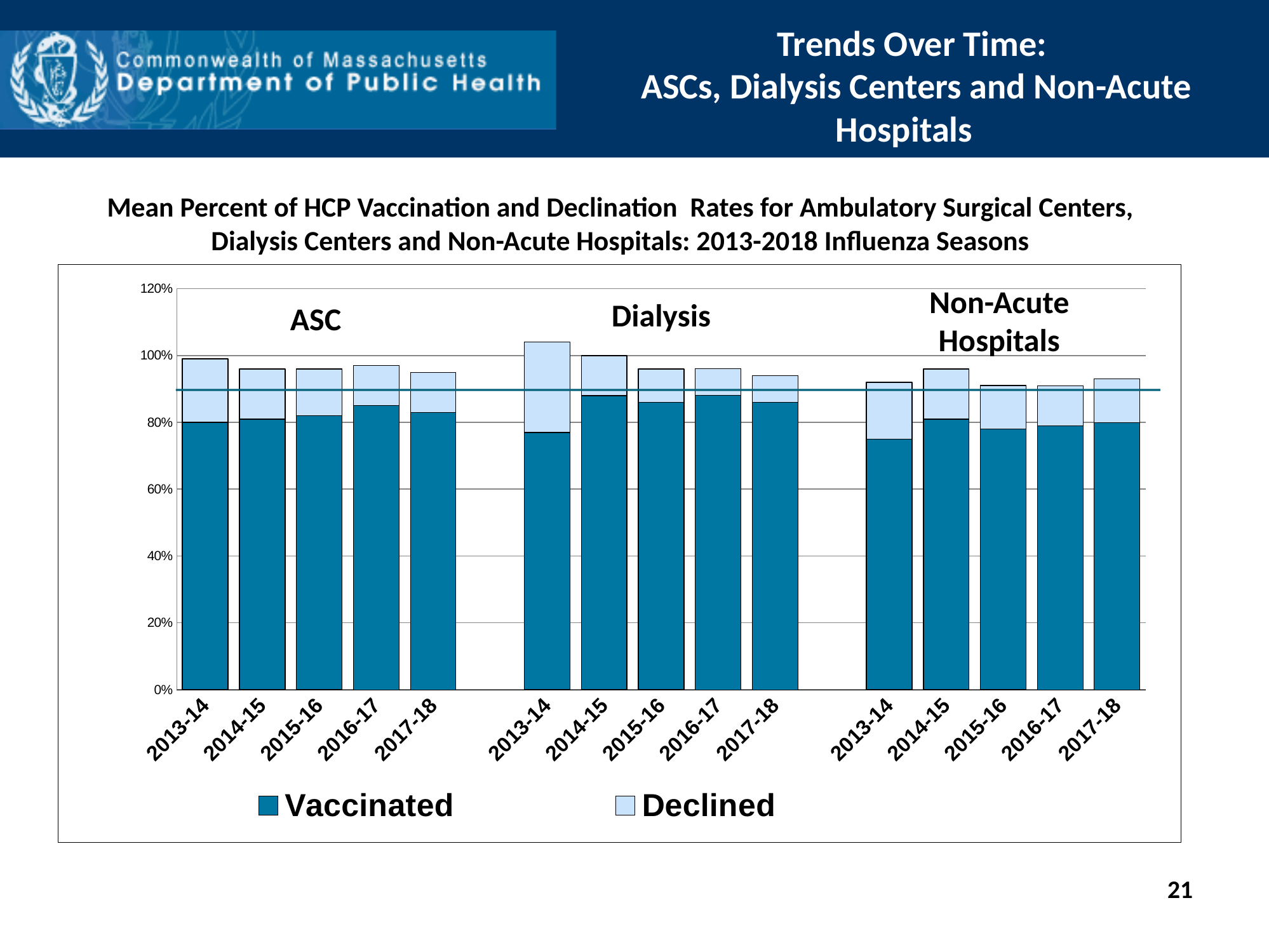
How many series does the legend list? 2 Which season has the lowest Vaccinated value within the Dialysis group? 2013-14 What kind of chart is shown on the slide? Stacked bar chart Is the Vaccinated value for ASC in 2016-17 greater or less than 80%? greater Which bar has the highest combined Vaccinated plus Declined total on the chart? Dialysis 2013-14 Is the Vaccinated value for Dialysis in 2014-15 greater or less than 80%? greater Which season has the lowest Vaccinated value within the Non-Acute Hospitals group? 2013-14 What are the two series named in the legend? Vaccinated and Declined How many bars are plotted in the chart in total? 15 Is the Vaccinated value for Dialysis in 2013-14 greater or less than 80%? less How many facility groups are labelled on the chart? 3